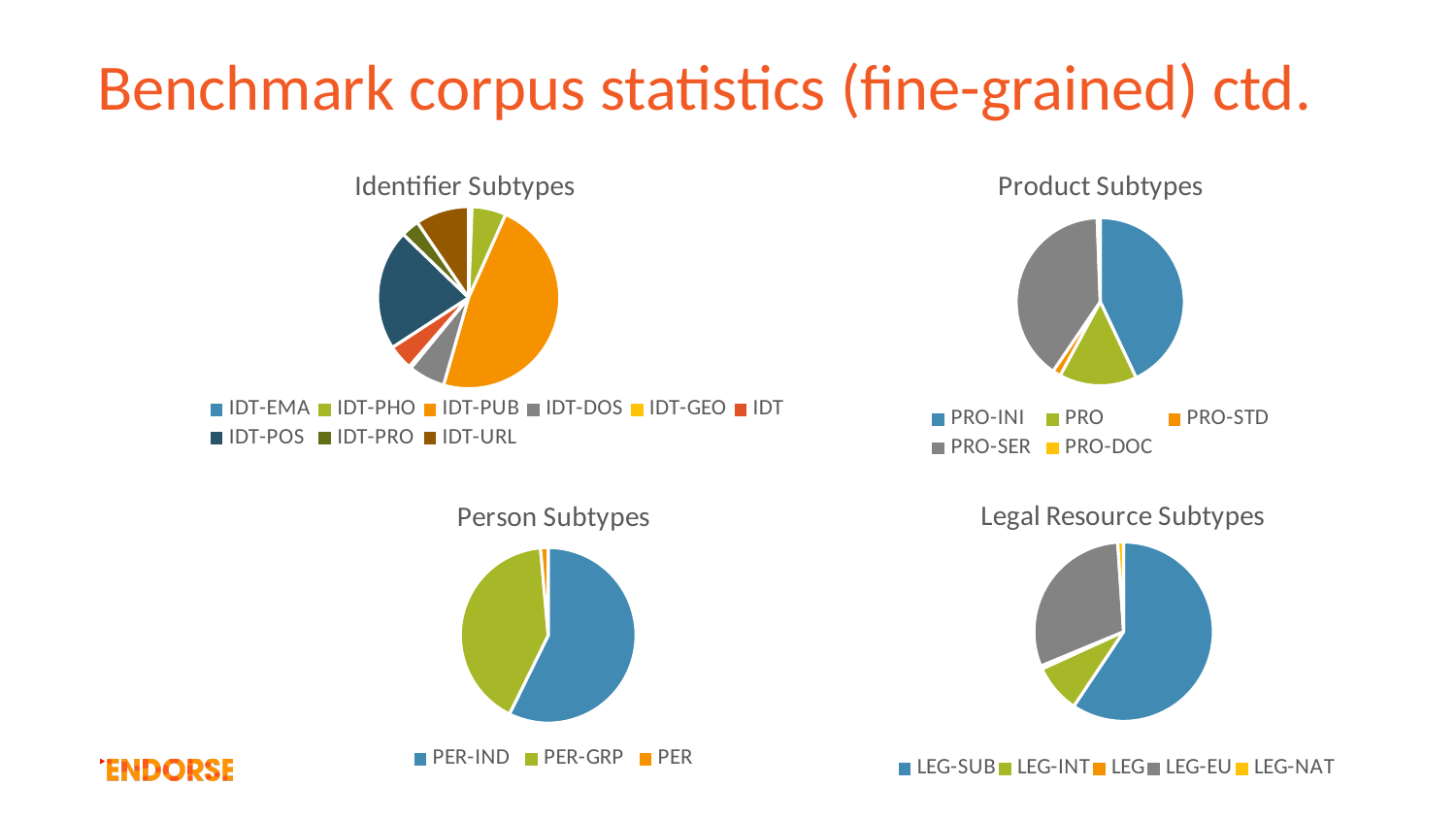
What kind of chart is the Identifier Subtypes chart? pie chart In the Legal Resource Subtypes chart, which subtype has the largest slice? LEG-SUB In the Legal Resource Subtypes chart, which is larger, the LEG-EU slice or the LEG-INT slice? LEG-EU In the Person Subtypes chart, which subtype has the largest slice? PER-IND In the Product Subtypes chart, how many entries does the legend list? 5 In the Person Subtypes chart, which subtype has the smallest slice? PER In the Identifier Subtypes chart, how many entries does the legend list? 9 In the Person Subtypes chart, how many entries does the legend list? 3 How many charts are shown on the slide? 4 What is the title of the chart in the bottom-right of the slide? Legal Resource Subtypes In the Product Subtypes chart, which is larger, the PRO slice or the PRO-STD slice? PRO In the Identifier Subtypes chart, which subtype has the largest slice? IDT-PUB